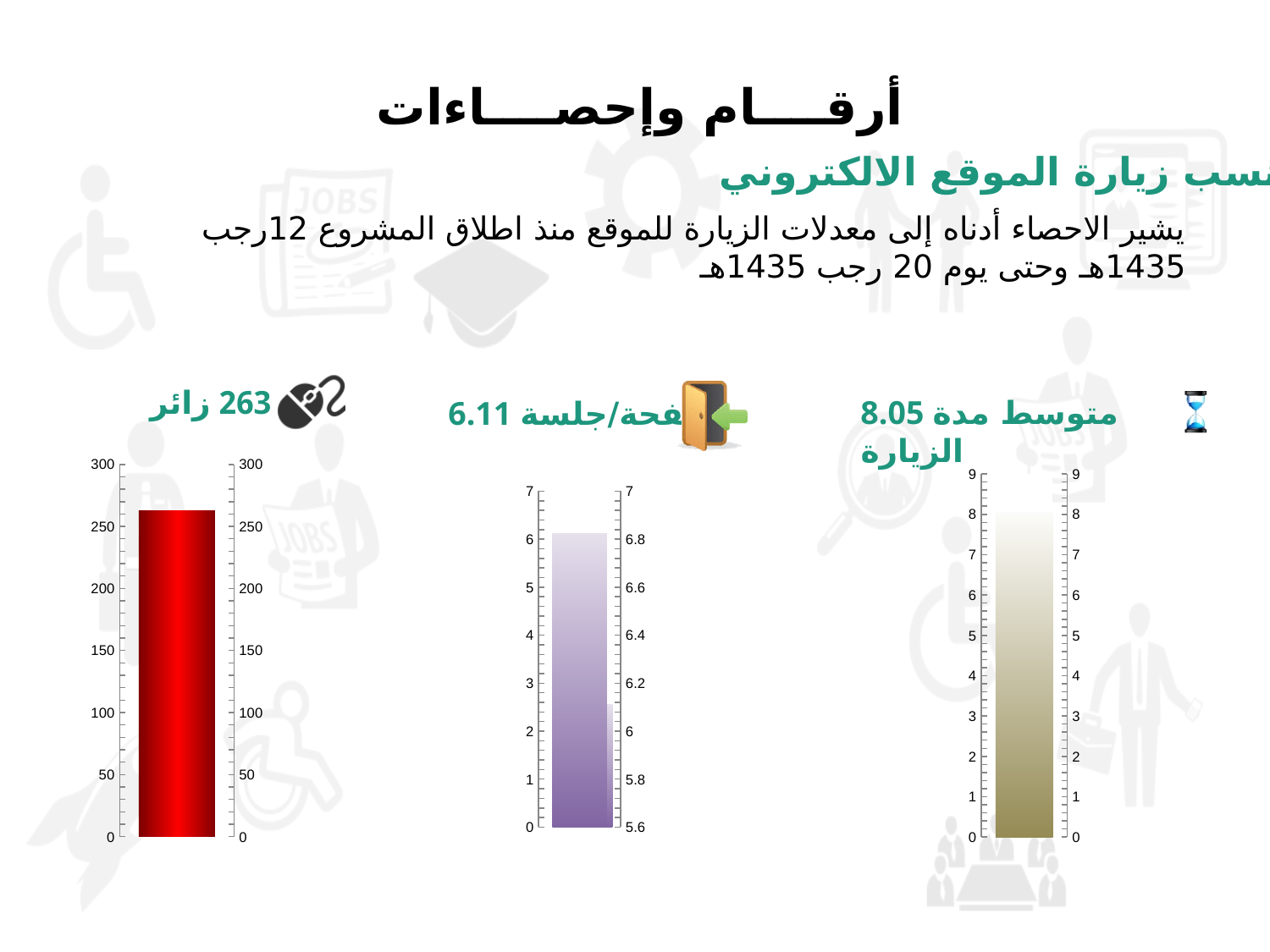
What average visit duration value is shown above the right chart? 8.05 On the left chart, is the value of the bar greater or less than 250? greater On the right chart, is the value of the bar greater or less than 9? less On the right chart, is the value of the bar greater or less than 7? greater How many bars does the left chart show? 1 What type of chart is the left chart on the slide? bar chart What pages-per-session value is shown above the middle chart? 6.11 What is the number of visitors shown above the left chart? 263 What colour is the bar in the left chart? red